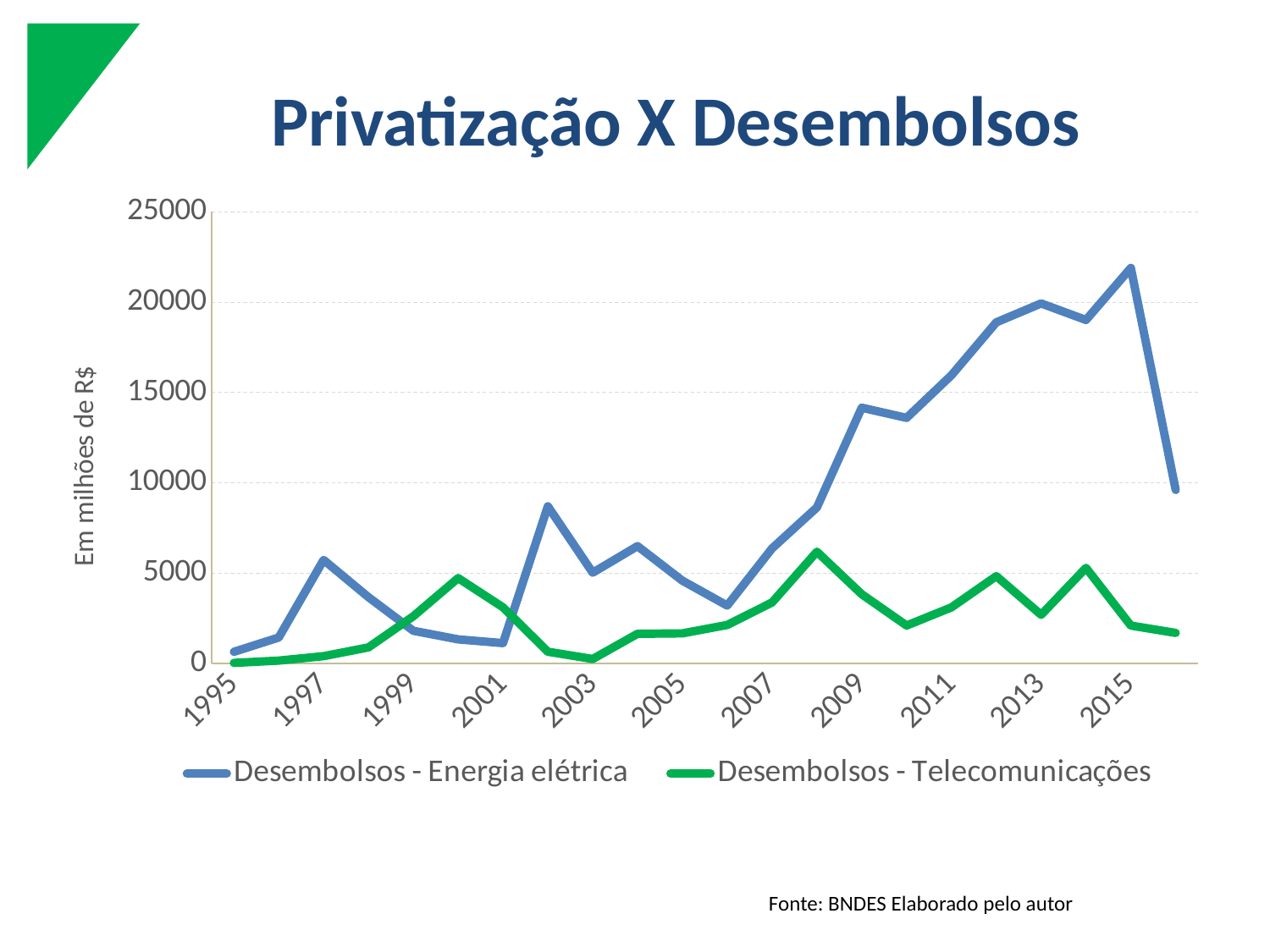
In which year does the Desembolsos - Telecomunicações series reach its highest value? 2008 Is the value for Desembolsos - Telecomunicações in 2003 greater or less than 5000? less How many series does the legend list? 2 Is the value for Desembolsos - Telecomunicações in 2008 greater or less than 5000? greater What kind of chart is shown on the slide? line chart In which year does the Desembolsos - Energia elétrica series reach its highest value? 2015 Is the value for Desembolsos - Energia elétrica in 2015 greater or less than 20000? greater What is the title of the chart? Privatização X Desembolsos Does the Desembolsos - Energia elétrica series generally rise or fall between 2009 and 2015? rise What is the label on the vertical axis? Em milhões de R$ In 2000, which series has the larger value: Desembolsos - Energia elétrica or Desembolsos - Telecomunicações? Desembolsos - Telecomunicações